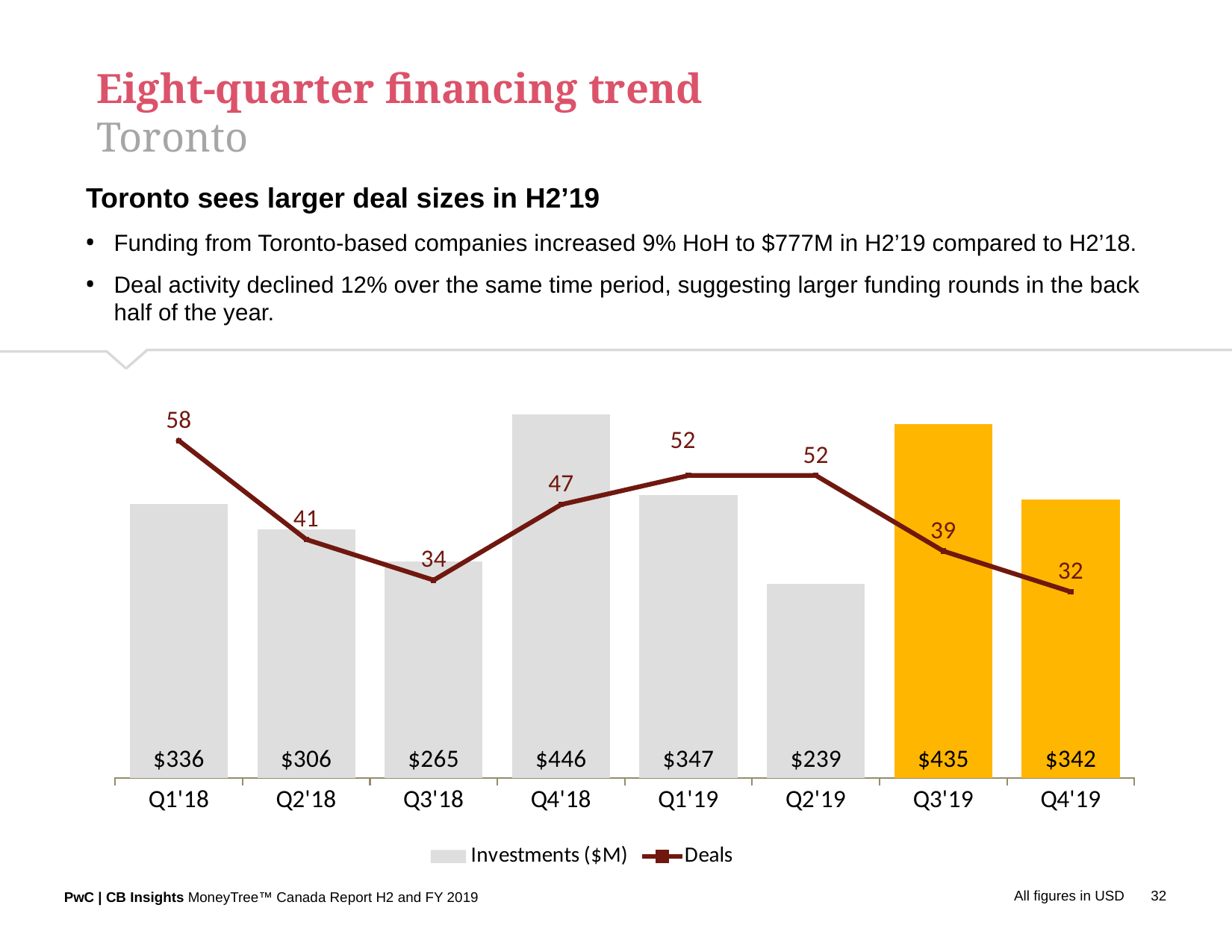
What is the difference in Investments ($M) between Q3'19 and Q4'19? $93 Which quarter has the highest number of Deals? Q1'18 What is the Investments ($M) value for Q4'18? $446 What is the difference in Deals between Q1'18 and Q4'19? 26 What kind of chart is used to show Investments ($M)? Bar chart Which quarter has the lowest Investments ($M) value? Q2'19 How many series does the legend list? 2 Which quarter has more Deals, Q2'18 or Q4'18? Q4'18 How many quarters are shown on the x axis? 8 How many Deals were there in Q3'18? 34 What is the Investments ($M) value for Q3'19? $435 Do the Deals values rise or fall from Q2'19 to Q4'19? Fall